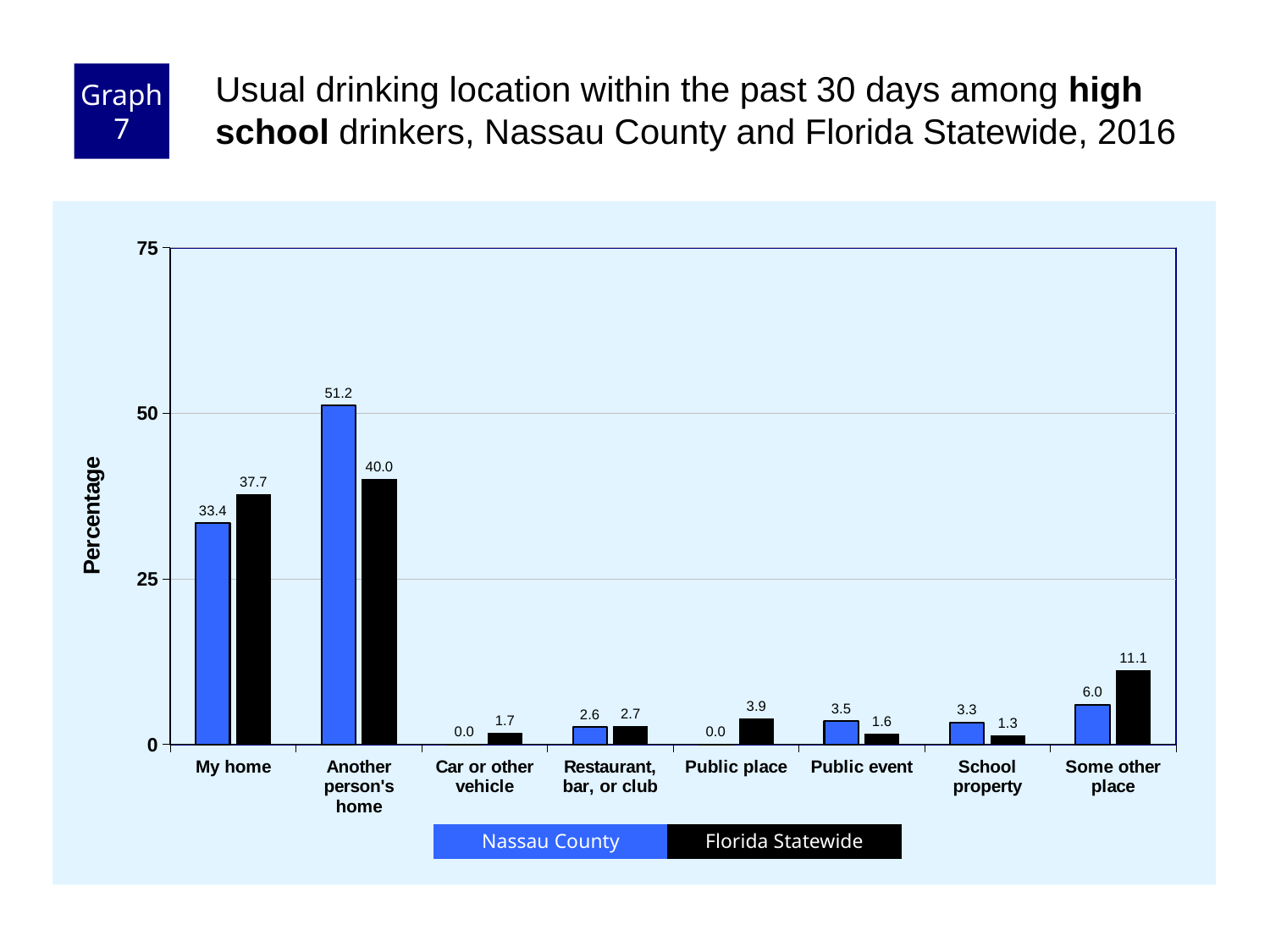
What is the Florida Statewide value for "Some other place"? 11.1 How many series does the legend list? 2 What is the label of the y axis? Percentage Which category has the highest Nassau County value? Another person's home Which is larger for "Public event": the Nassau County value or the Florida Statewide value? Nassau County Is the Nassau County value for "Another person's home" greater or less than 50? greater What kind of chart is shown on the slide? Bar chart What is the difference between the Nassau County and Florida Statewide values for "Another person's home"? 11.2 Which category has the lowest Florida Statewide value? School property What is the Nassau County value for "Another person's home"? 51.2 How many categories are shown on the x axis? 8 What is the Florida Statewide value for "My home"? 37.7